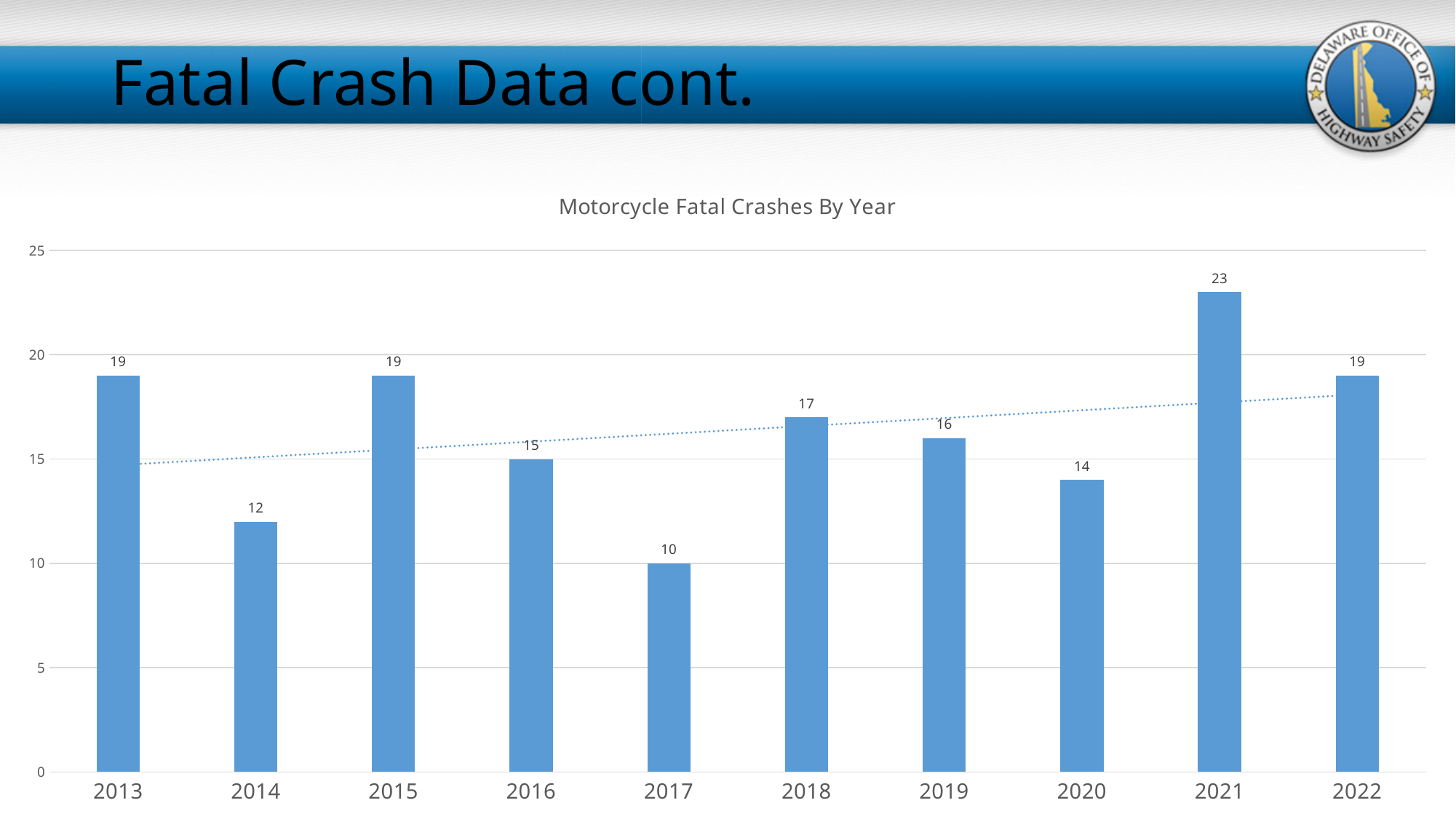
How many years are shown on the x axis? 10 What is the value for 2021? 23 What is the title of the chart? Motorcycle Fatal Crashes By Year Which is larger, the value for 2014 or the value for 2016? 2016 Is the value for 2022 greater or less than 15? greater What is the difference between the values for 2018 and 2019? 1 What is the difference between the values for 2021 and 2017? 13 What kind of chart is shown on the slide? bar chart Which year has the highest number of motorcycle fatal crashes? 2021 What is the value for 2020? 14 What is the value for 2017? 10 Which year has the lowest number of motorcycle fatal crashes? 2017